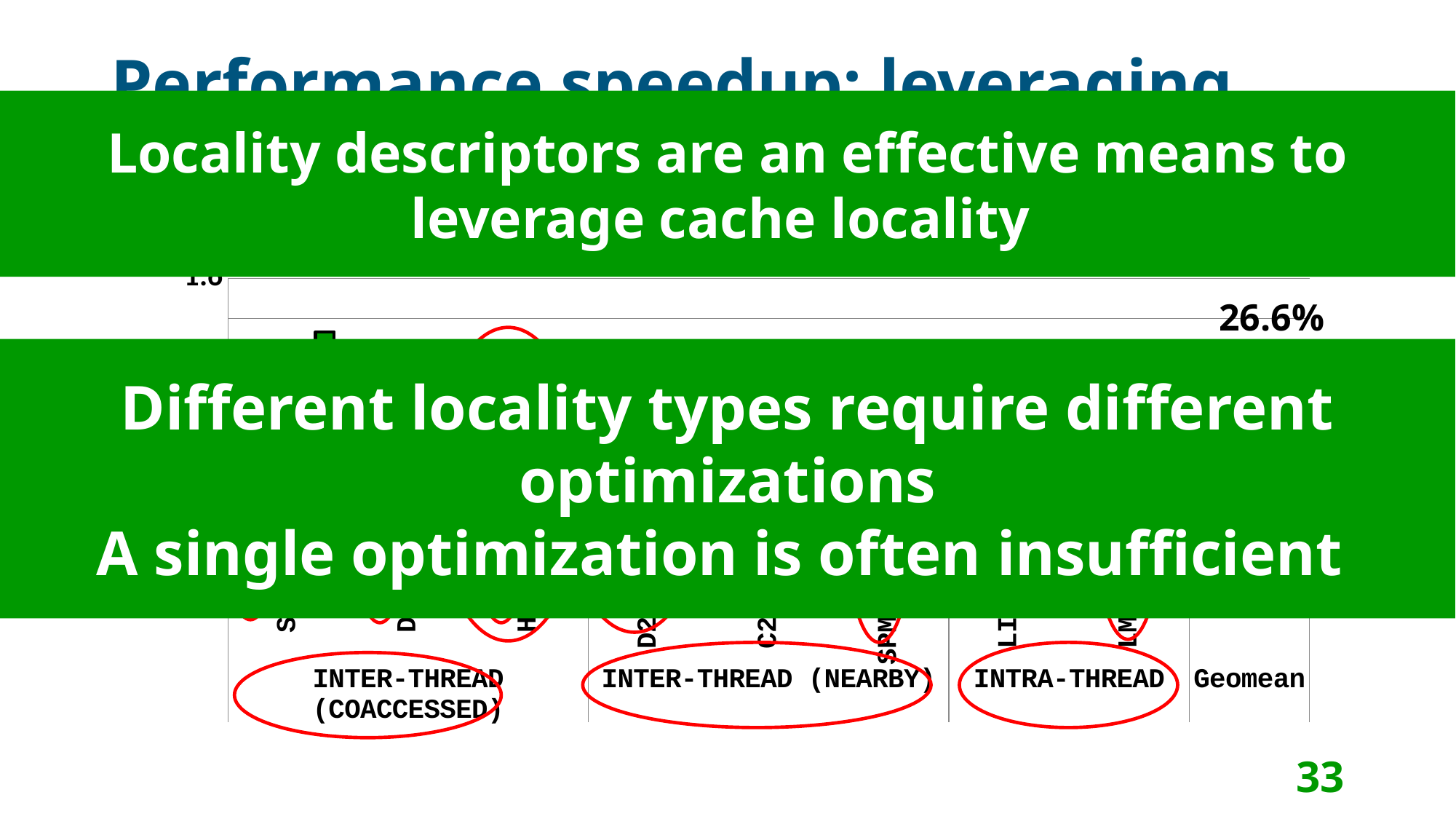
How many x-axis group labels are circled in red in the chart? 3 How many category groups are labeled along the x axis of the chart? 4 What kind of chart is shown on the slide? bar chart What value label is printed above the Geomean group in the chart? 26.6% Which x-axis group label is the rightmost in the chart? Geomean